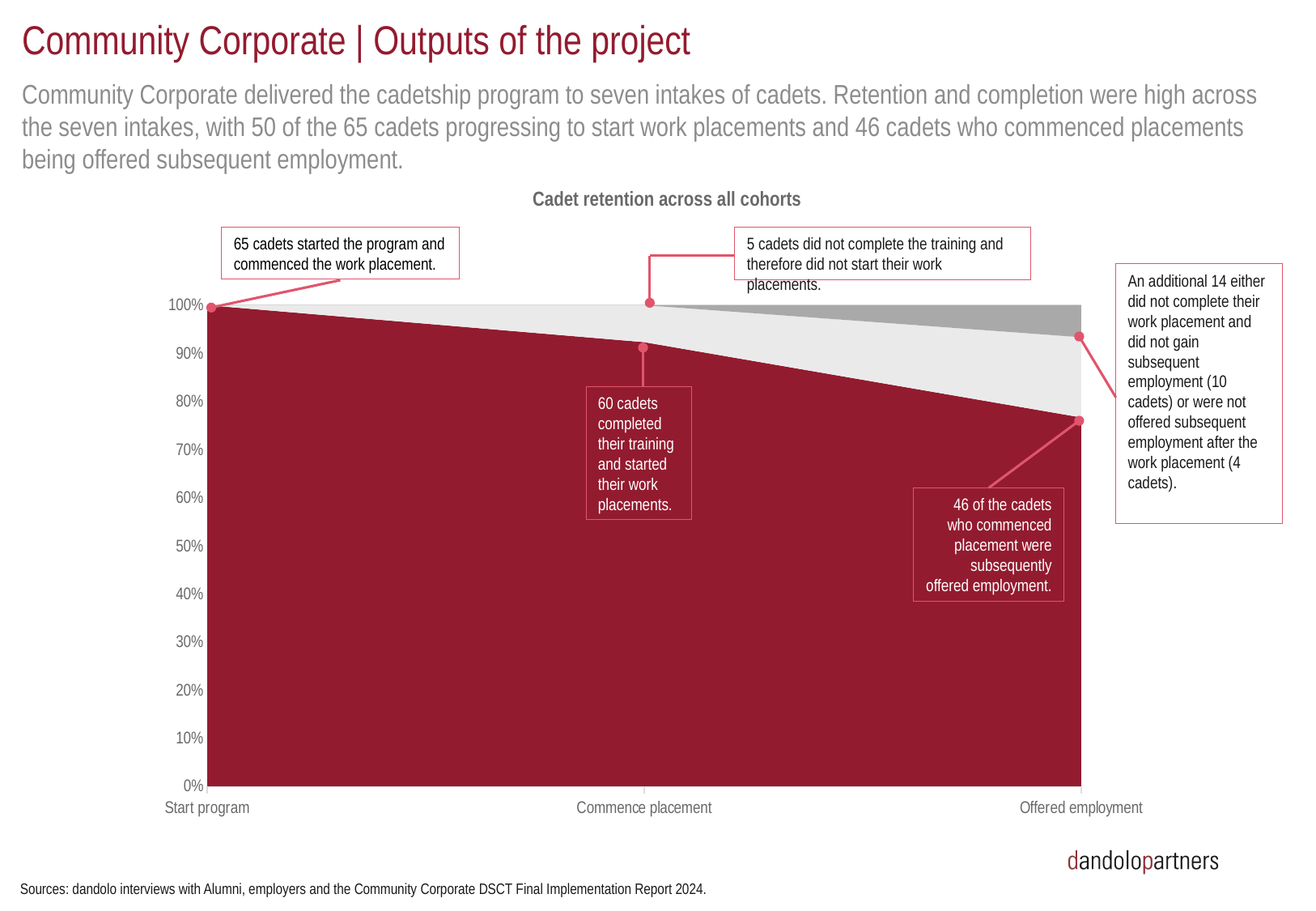
According to the chart annotation, how many cadets completed their training and started their work placements? 60 According to the chart annotation, how many cadets who commenced placement were subsequently offered employment? 46 Does the dark red retained-cadet area rise or fall from Start program to Offered employment? Fall How many stages are shown along the x axis of the chart? 3 Is the retained share at Commence placement greater or less than 80%? greater Is the retained share at Offered employment greater or less than 80%? less According to the chart annotation, how many cadets started the program? 65 According to the chart annotation, how many cadets were not offered subsequent employment after the work placement? 4 How many more cadets started the program than were offered employment? 19 According to the chart annotation, how many cadets did not complete the training and therefore did not start their work placements? 5 What kind of chart is shown on the slide? Area chart What is the title of the chart? Cadet retention across all cohorts